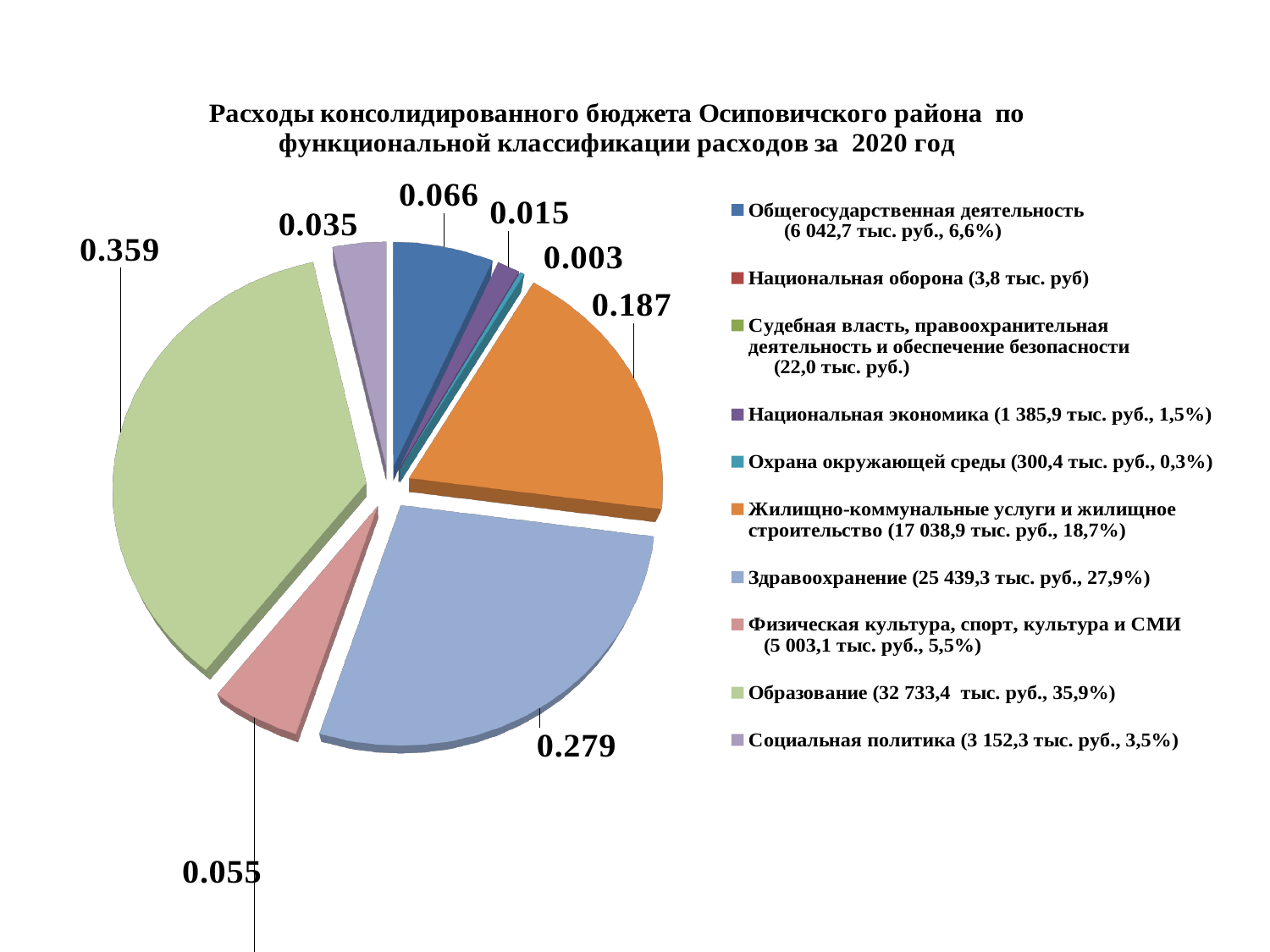
How many categories does the legend list? 10 Which is larger, the slice for Физическая культура, спорт, культура и СМИ or the slice for Социальная политика? Физическая культура, спорт, культура и СМИ Which category has the largest slice of the pie? Образование What is the value shown for the Образование slice? 0.359 What is the value shown for the Жилищно-коммунальные услуги и жилищное строительство slice? 0.187 What is the difference between the values for Образование and Здравоохранение? 0.080 For which year does the chart show the expenditures of the consolidated budget of the Osipovichi district? 2020 What is the value shown for the Здравоохранение slice? 0.279 What kind of chart is shown on the slide? pie chart What is the value shown for the Социальная политика slice? 0.035 What is the value shown for the Общегосударственная деятельность slice? 0.066 According to the legend, what amount in thousand rubles is given for Здравоохранение? 25 439,3 тыс. руб.